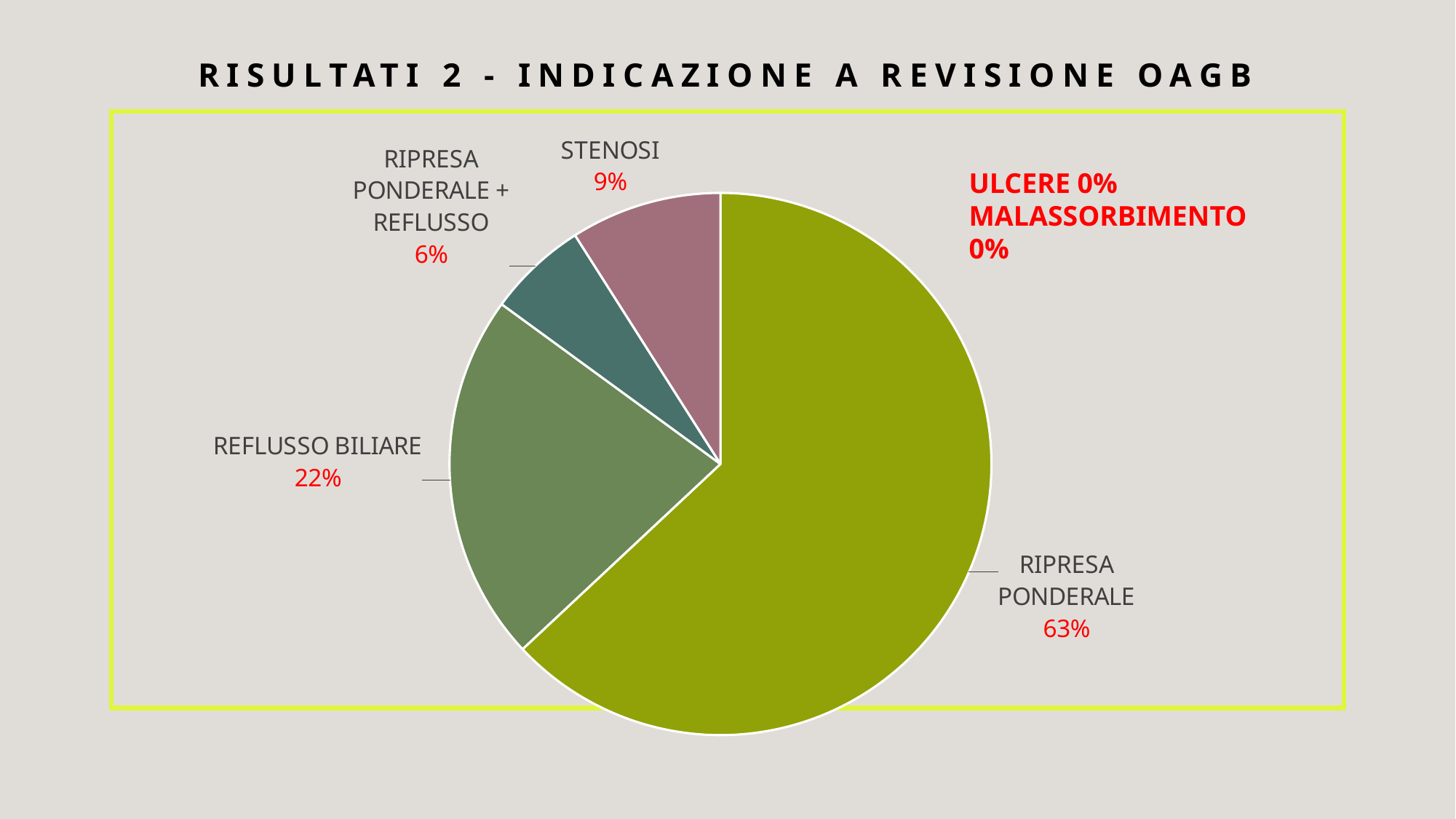
What is the value shown for RIPRESA PONDERALE + REFLUSSO? 6% What is the value shown for STENOSI? 9% What is the value shown for REFLUSSO BILIARE? 22% Which is larger, STENOSI or RIPRESA PONDERALE + REFLUSSO? STENOSI Which category has the largest slice of the pie? RIPRESA PONDERALE What share of the pie does RIPRESA PONDERALE represent? 63% Which category has the smallest visible slice of the pie? RIPRESA PONDERALE + REFLUSSO What is the title of the slide? RISULTATI 2 - INDICAZIONE A REVISIONE OAGB How many slices are visible in the pie chart? 4 What is the difference in percentage points between RIPRESA PONDERALE and REFLUSSO BILIARE? 41 What percentage is given for ULCERE on the slide? 0% What kind of chart is shown on the slide? Pie chart